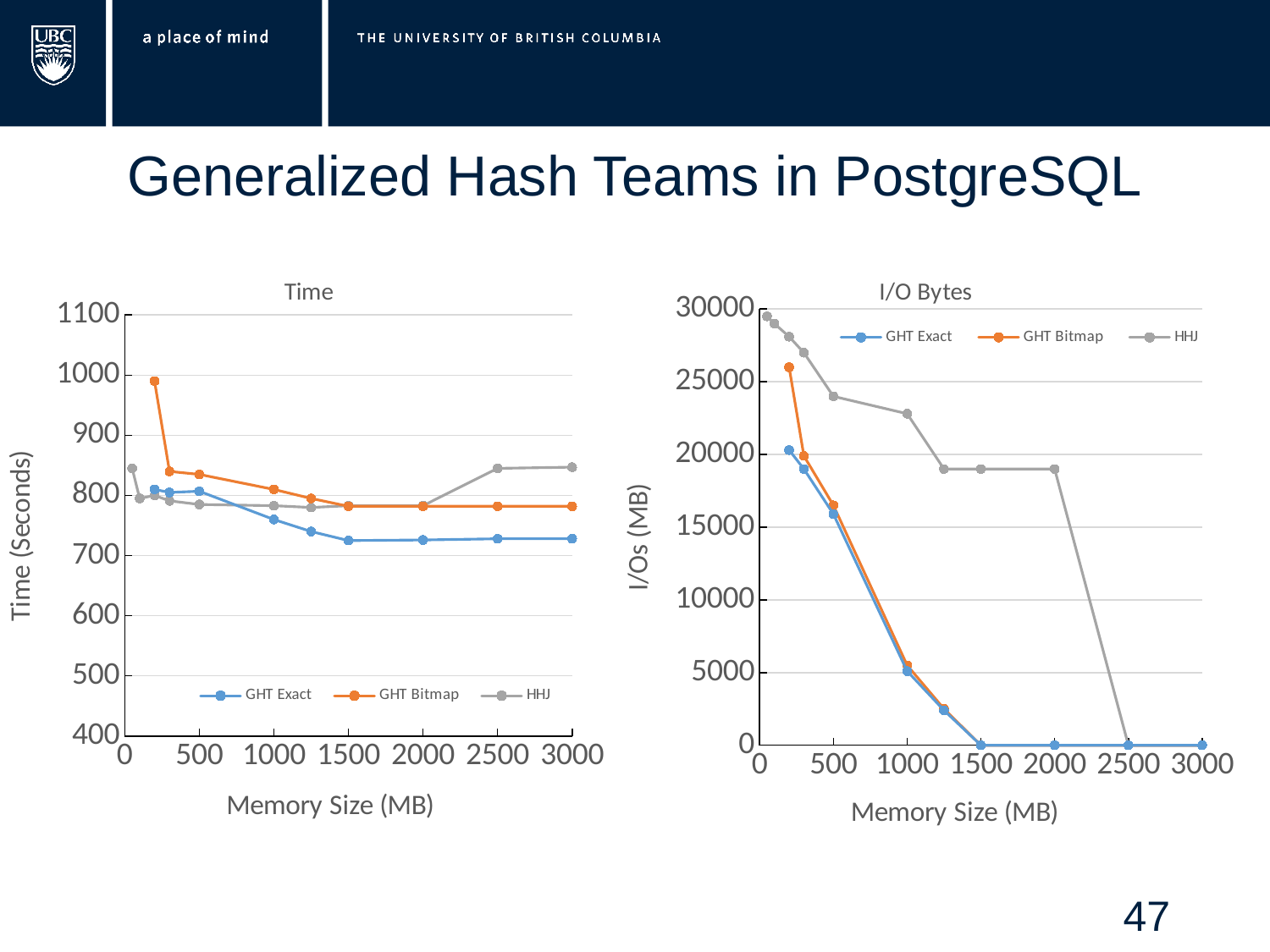
What kind of chart is the "Time" chart on the left? line chart In the "I/O Bytes" chart, is the HHJ value at 2500 MB greater or less than 5000? less In the "Time" chart, which series has the highest value at 200 MB? GHT Bitmap In the "I/O Bytes" chart, is the HHJ value at 1000 MB greater or less than 20000? greater In the "Time" chart, is the GHT Bitmap value at 200 MB greater or less than 900? greater In the "I/O Bytes" chart, does the GHT Exact series rise or fall as memory size increases? fall In the "Time" chart, which series has the higher value at 3000 MB, HHJ or GHT Exact? HHJ In the "I/O Bytes" chart, which series has the higher value at 2000 MB, HHJ or GHT Bitmap? HHJ How many series does the legend of the "I/O Bytes" chart list? 3 What is the y-axis label of the "I/O Bytes" chart? I/Os (MB)